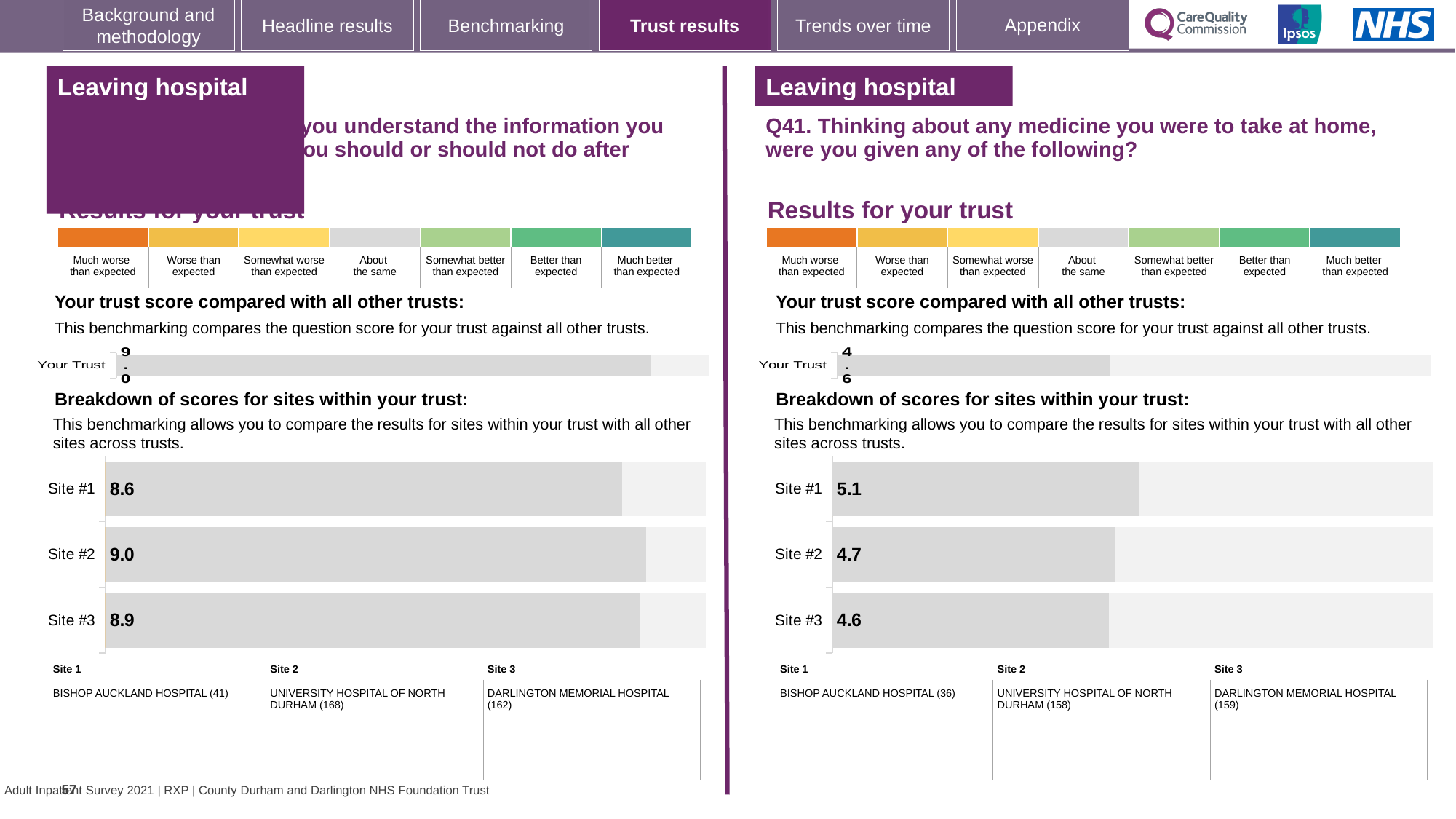
On the right-hand (Q41) site breakdown chart, what is the difference between the scores for Site #1 and Site #3? 0.5 What type of chart is used for the site breakdown on the right-hand (Q41) side of the slide? Bar chart On the left-hand site breakdown chart, what is the score for Site #2? 9.0 On the left-hand site breakdown chart, what is the score for Site #1? 8.6 On the right-hand (Q41) site breakdown chart, what is the score for Site #1? 5.1 On the left-hand site breakdown chart, which site has the lowest score? Site #1 On the left-hand site breakdown chart, what is the difference between the scores for Site #2 and Site #1? 0.4 On the right-hand (Q41) site breakdown chart, which site has the highest score? Site #1 On the right-hand (Q41) site breakdown chart, which has the larger score, Site #2 or Site #3? Site #2 On the right-hand (Q41) site breakdown chart, what is the score for Site #3? 4.6 On the right-hand (Q41) 'Your trust score compared with all other trusts' chart, what is the score shown for Your Trust? 4.6 How many sites are shown on the left-hand site breakdown chart? 3